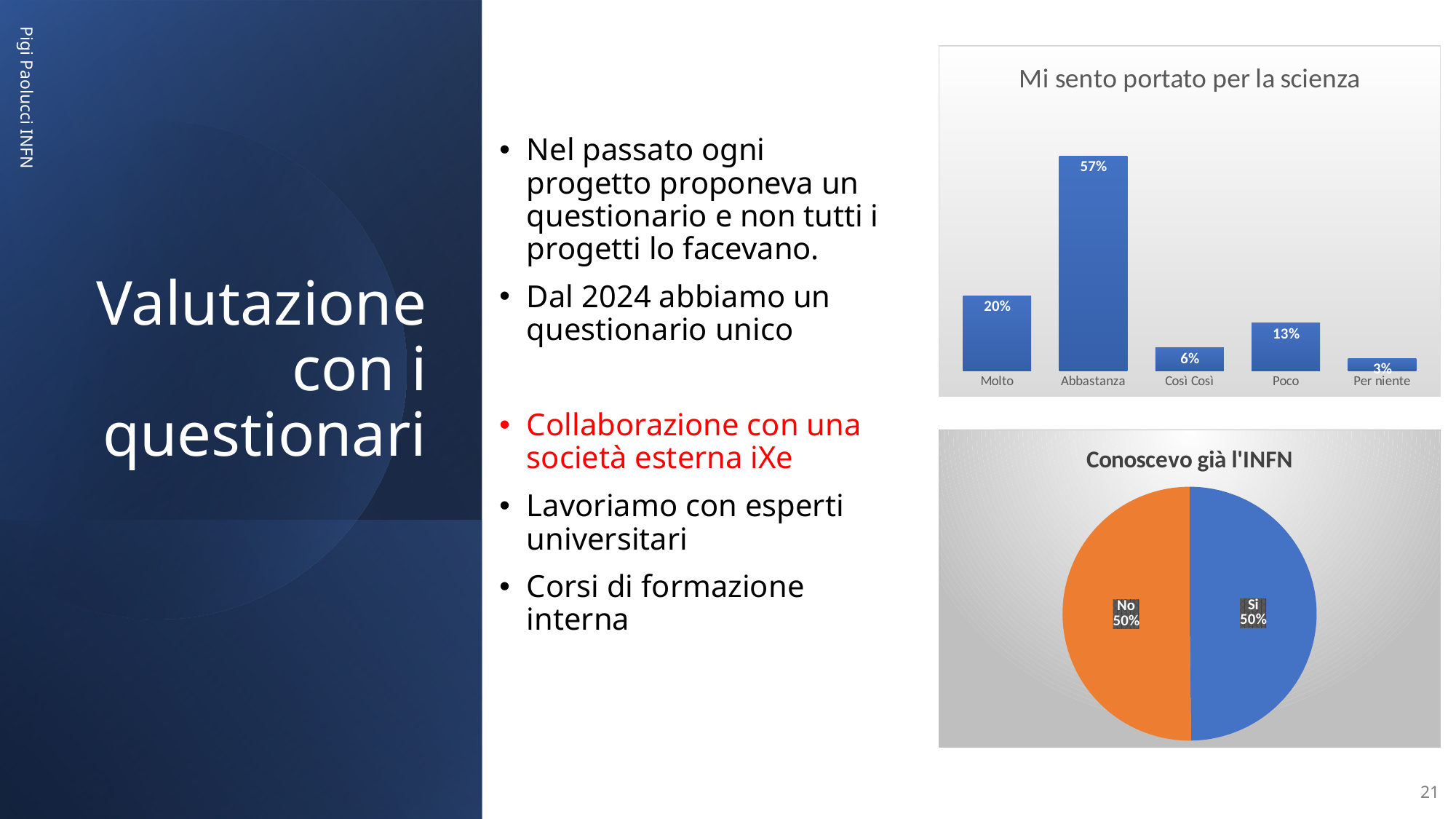
In the 'Conoscevo già l'INFN' chart, what share does the Si slice have? 50% How many categories are shown in the 'Mi sento portato per la scienza' chart? 5 What kind of chart is 'Mi sento portato per la scienza'? Bar chart In the 'Mi sento portato per la scienza' chart, what is the value for Molto? 20% In the 'Mi sento portato per la scienza' chart, what is the difference between Abbastanza and Molto? 37% In the 'Mi sento portato per la scienza' chart, which is larger, Poco or Così Così? Poco In the 'Mi sento portato per la scienza' chart, what is the value for Abbastanza? 57% In the 'Mi sento portato per la scienza' chart, which category has the lowest value? Per niente What kind of chart is 'Conoscevo già l'INFN'? Pie chart In the 'Mi sento portato per la scienza' chart, what is the value for Poco? 13% In the 'Mi sento portato per la scienza' chart, which category has the highest value? Abbastanza In the 'Mi sento portato per la scienza' chart, what is the value for Così Così? 6%